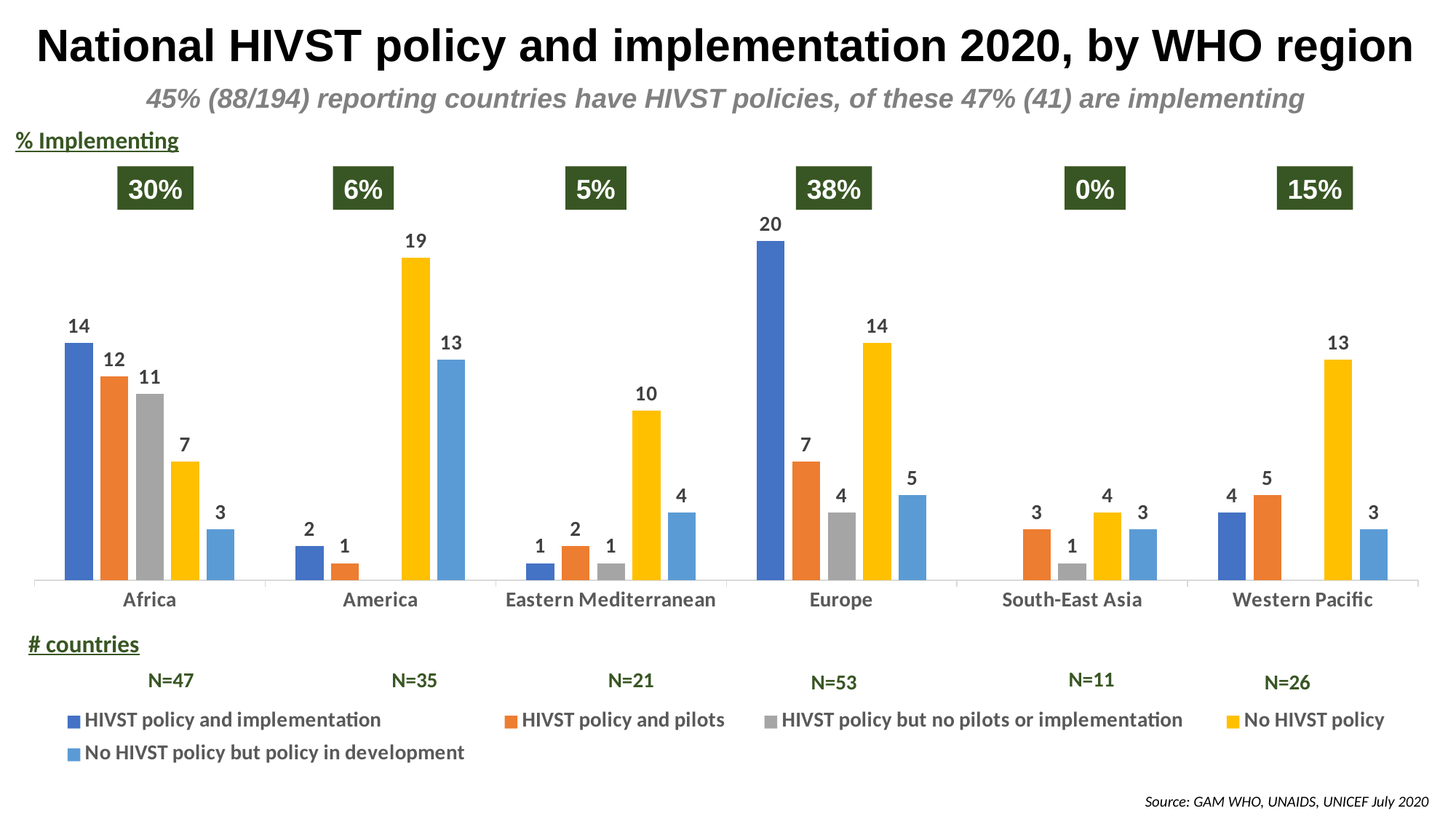
What is the value for 'HIVST policy and implementation' in Europe? 20 What is the difference between the 'No HIVST policy' values for America and Western Pacific? 6 What is the value for 'No HIVST policy but policy in development' in Eastern Mediterranean? 4 How many regions are shown on the x axis? 6 What kind of chart is shown on the slide? Bar chart Which is larger: 'HIVST policy and pilots' in Africa or 'HIVST policy and pilots' in Europe? Africa What is the value for 'No HIVST policy' in America? 19 Which region has the highest value for 'HIVST policy and implementation'? Europe What is the '% Implementing' figure shown above the Europe group? 38% How many series does the legend list? 5 Which region has the lowest value for 'No HIVST policy'? South-East Asia What is the value for 'HIVST policy but no pilots or implementation' in Africa? 11